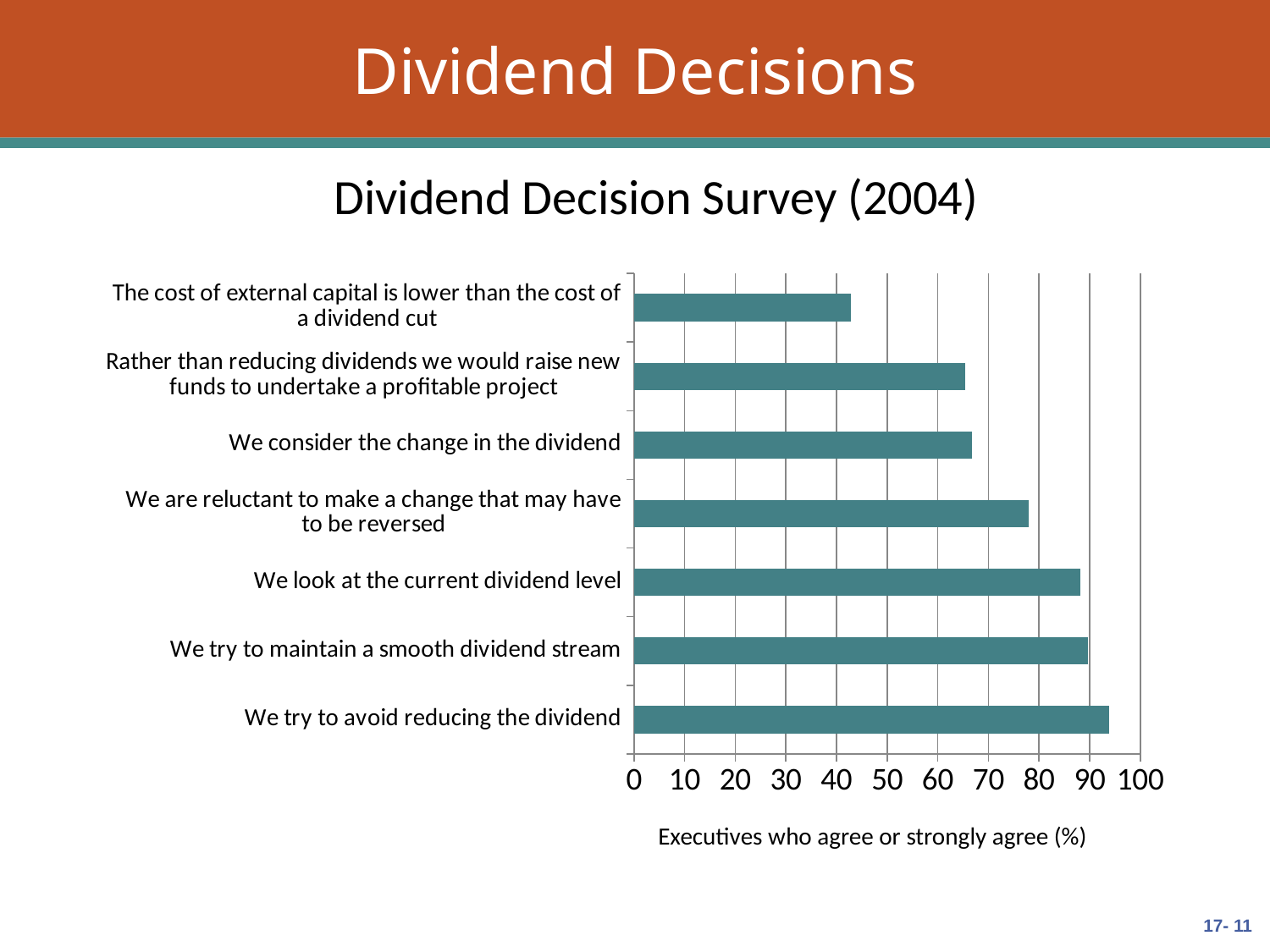
Is the value for "Rather than reducing dividends we would raise new funds to undertake a profitable project" greater or less than 60? greater Is the value for "The cost of external capital is lower than the cost of a dividend cut" greater or less than 50? less How many survey statements (categories) are plotted in the chart? 7 Which is larger: the value for "We look at the current dividend level" or the value for "We are reluctant to make a change that may have to be reversed"? We look at the current dividend level Which statement has the highest percentage of executives who agree or strongly agree? We try to avoid reducing the dividend Is the value for "We try to avoid reducing the dividend" greater or less than 90? greater Which statement has the lowest percentage of executives who agree or strongly agree? The cost of external capital is lower than the cost of a dividend cut What is the title of the chart? Dividend Decision Survey (2004) What is the label on the horizontal axis of the chart? Executives who agree or strongly agree (%) What kind of chart is shown on the slide? bar chart